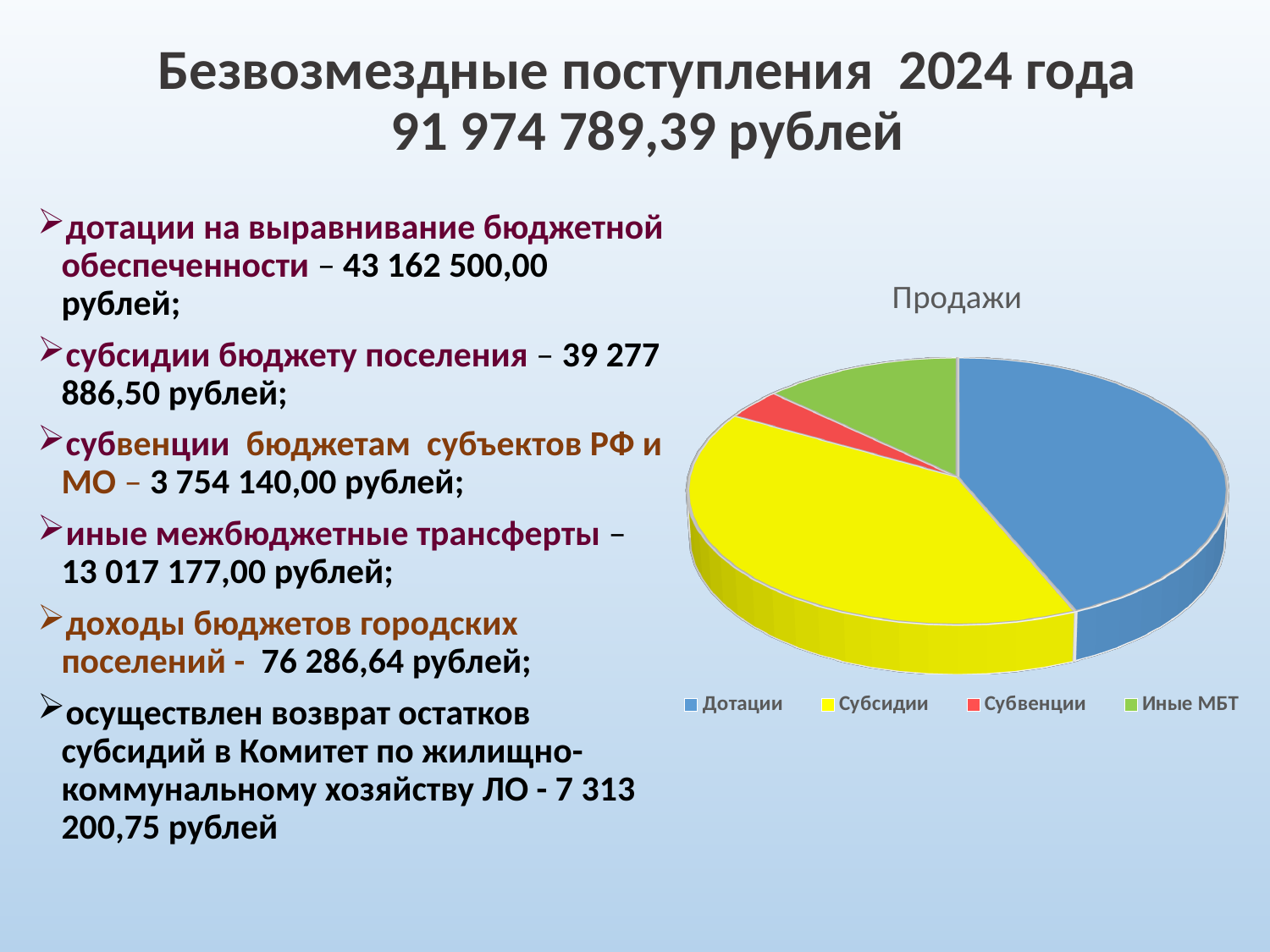
How many slices does the pie chart have? 4 Which slice is larger in the pie chart, Иные МБТ or Субвенции? Иные МБТ Which slice is larger in the pie chart, Дотации or Субвенции? Дотации What is the title of the pie chart? Продажи How many entries does the legend of the pie chart list? 4 Which category has the smallest slice in the pie chart? Субвенции Which slice is larger in the pie chart, Субсидии or Иные МБТ? Субсидии What colour is the Субсидии slice in the pie chart? yellow What kind of chart is shown on the slide? pie chart